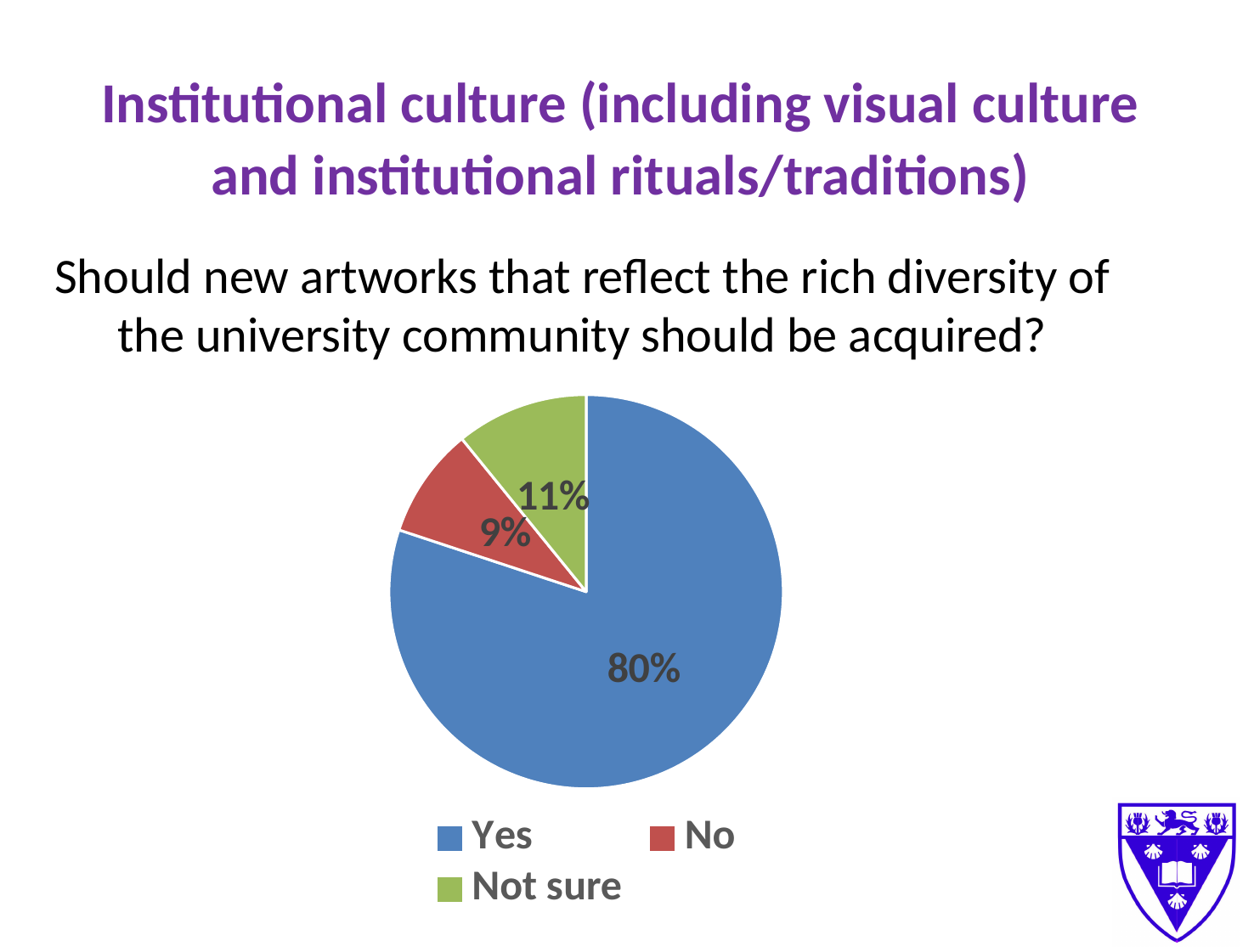
What type of chart is shown on the slide? pie chart What percentage of respondents answered "Not sure"? 11% What percentage of respondents answered "No"? 9% How many entries does the legend list? 3 Which is larger, the "Not sure" slice or the "No" slice? Not sure Which response has the smallest share of the pie? No What percentage of respondents answered "Yes"? 80% Which response has the largest share of the pie? Yes How many slices does the pie chart have? 3 What colour is the "Yes" slice? blue What colour is the "Not sure" slice? green What is the difference in percentage points between the "Yes" and "Not sure" slices? 69